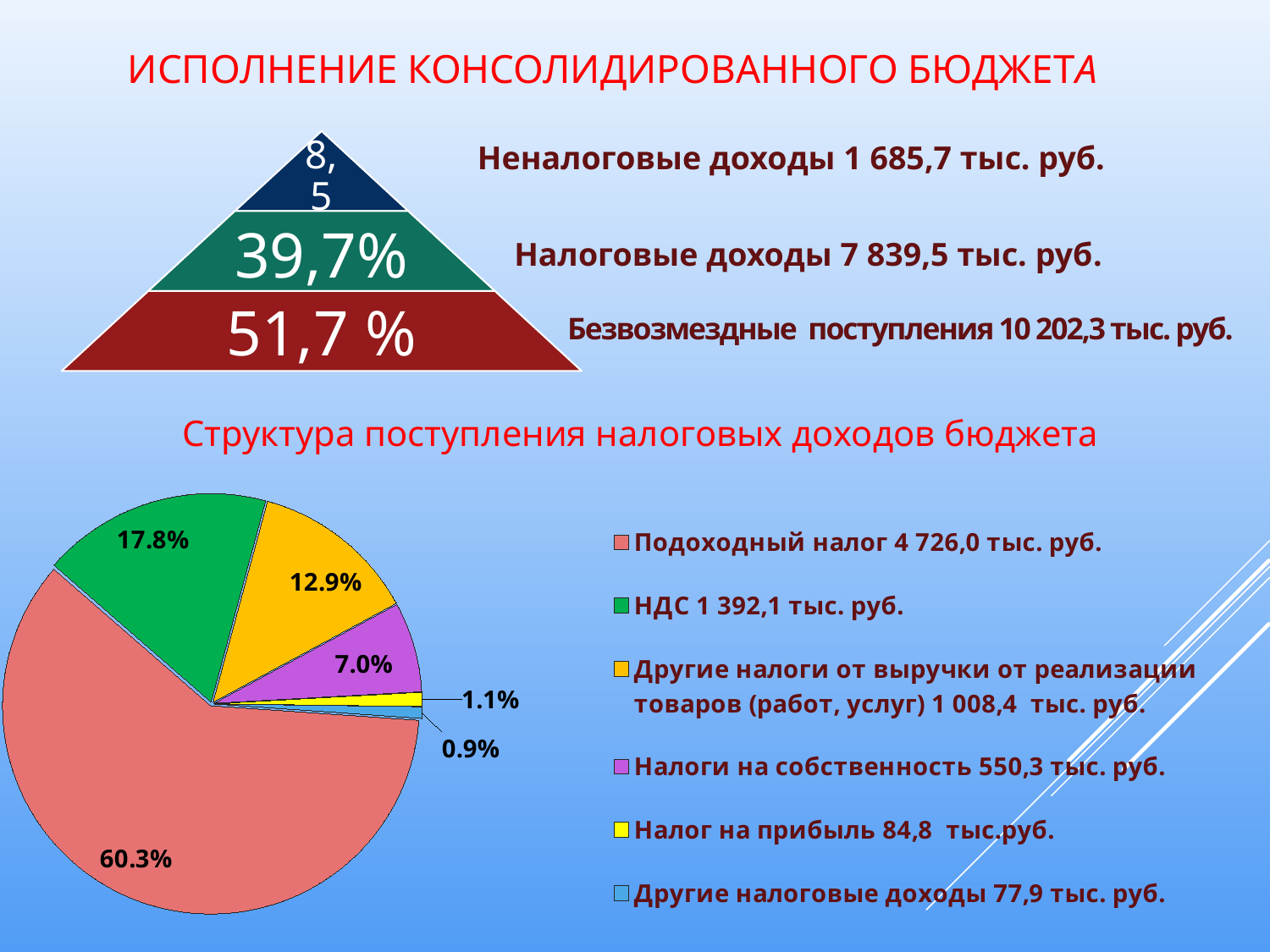
In the pie chart "Структура поступления налоговых доходов бюджета", what share is labelled for the slice "Подоходный налог"? 60.3% In the pie chart "Структура поступления налоговых доходов бюджета", what is the difference in percentage points between the "НДС" slice (17.8%) and the "Другие налоги от выручки от реализации товаров (работ, услуг)" slice (12.9%)? 4.9 percentage points In the pie chart "Структура поступления налоговых доходов бюджета", how many categories does the legend list? 6 What kind of chart is shown under the heading "Структура поступления налоговых доходов бюджета"? Pie chart In the pie chart "Структура поступления налоговых доходов бюджета", what share is labelled for "Налог на прибыль"? 1.1% In the pie chart "Структура поступления налоговых доходов бюджета", what colour is the slice for "Подоходный налог"? Salmon (pinkish red) In the pie chart "Структура поступления налоговых доходов бюджета", which slice is larger: "Налоги на собственность" or "Налог на прибыль"? Налоги на собственность In the pie chart "Структура поступления налоговых доходов бюджета", what share is labelled for "Налоги на собственность"? 7.0% In the pie chart "Структура поступления налоговых доходов бюджета", which category has the largest slice? Подоходный налог In the pie chart "Структура поступления налоговых доходов бюджета", which category has the smallest slice? Другие налоговые доходы According to the legend of the pie chart "Структура поступления налоговых доходов бюджета", what amount is given for "НДС"? 1 392,1 тыс. руб.